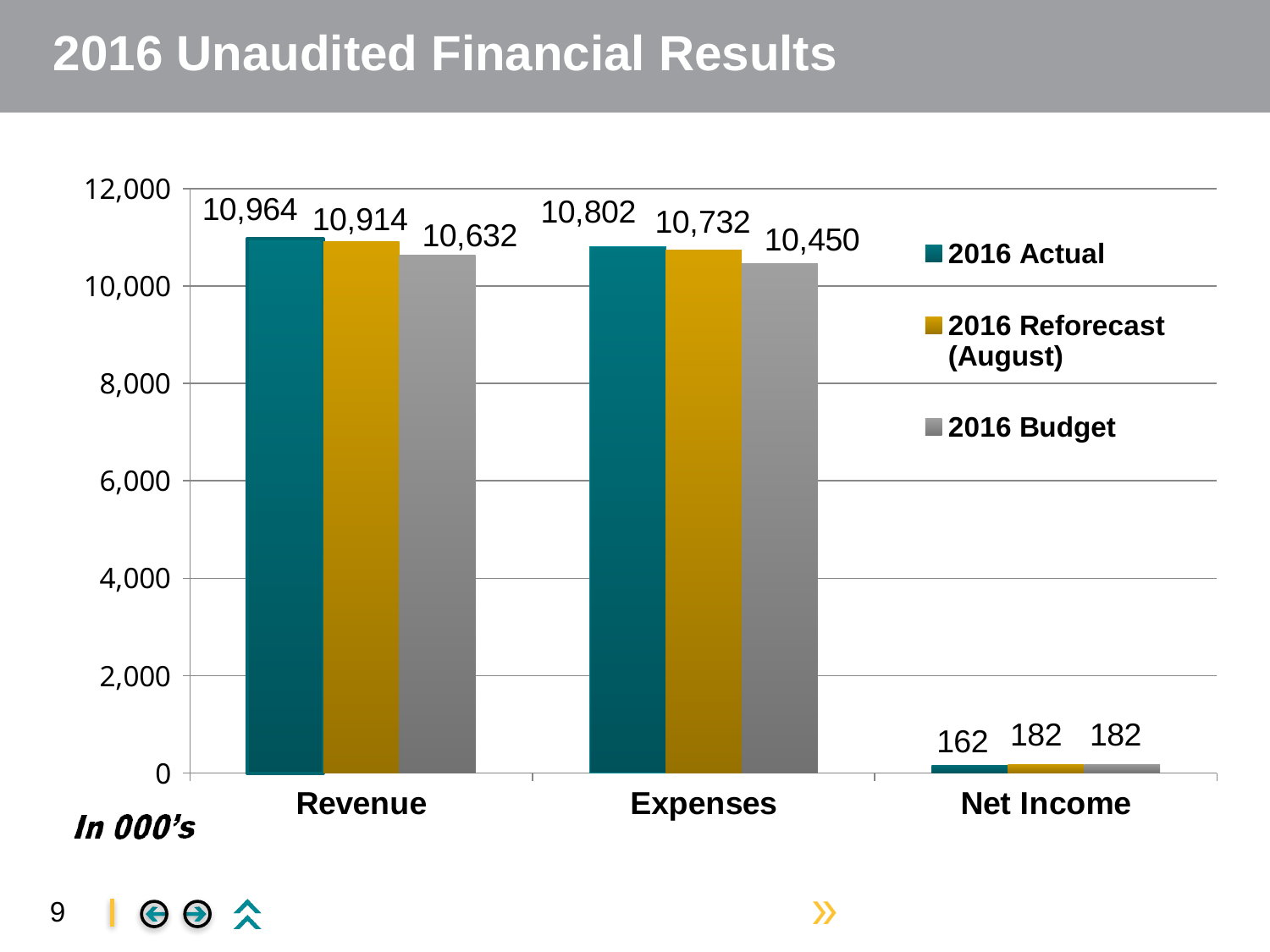
What is the 2016 Budget value for Expenses? 10,450 How many series does the legend list? 3 What kind of chart is shown on the slide? bar chart What is the difference between the 2016 Reforecast (August) and 2016 Actual values for Net Income? 20 What is the 2016 Actual value for Revenue? 10,964 What is the 2016 Reforecast (August) value for Net Income? 182 Which category has the highest 2016 Budget value? Revenue Is the 2016 Actual value for Expenses greater or less than 10,000? greater Which category has the lowest 2016 Actual value? Net Income How many categories are shown on the x axis? 3 Which is larger for Expenses: the 2016 Actual value or the 2016 Reforecast (August) value? 2016 Actual What is the difference between the 2016 Actual and 2016 Budget values for Revenue? 332